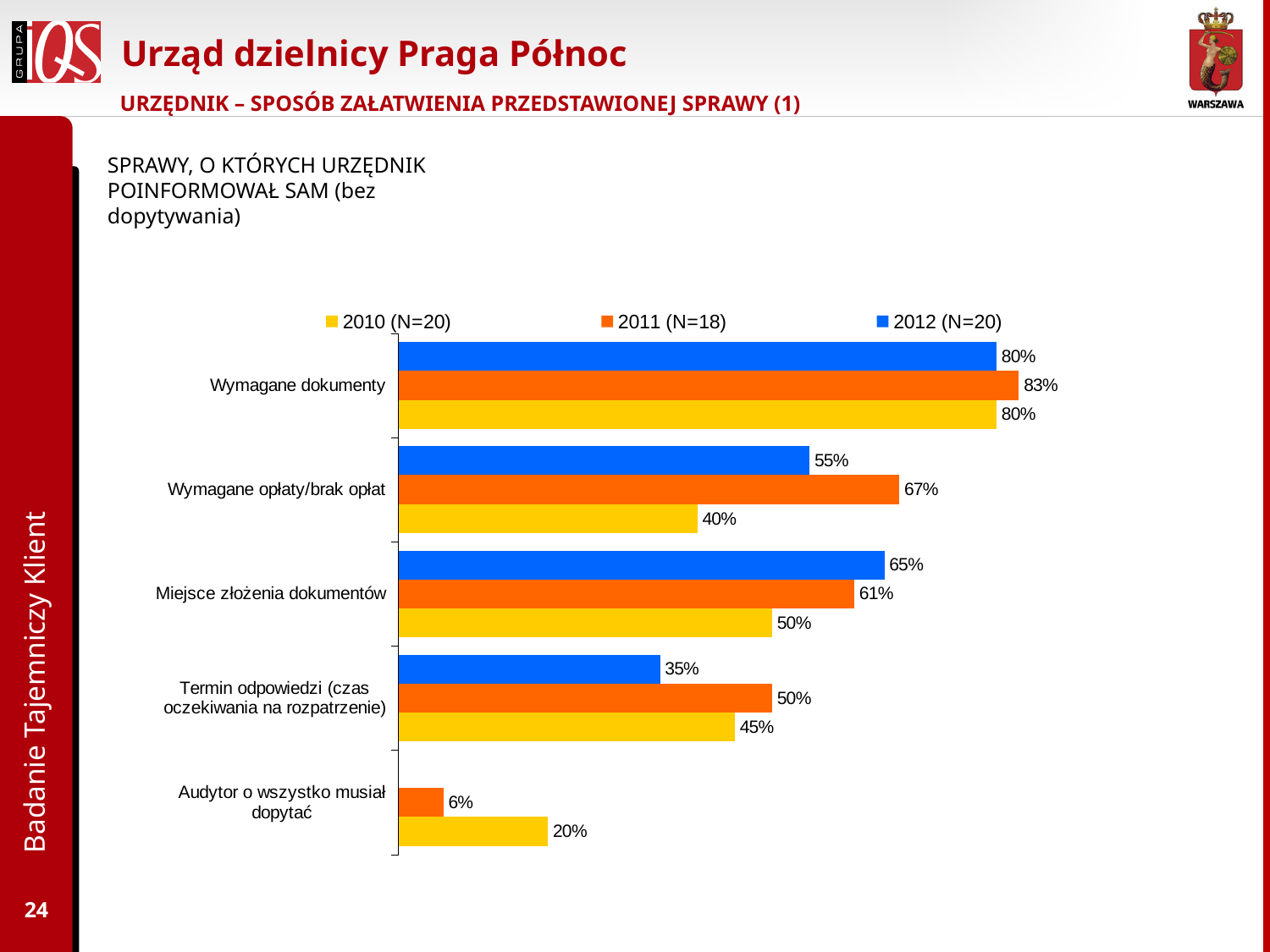
Which category has the lowest value in the 2010 (N=20) series? Audytor o wszystko musiał dopytać Which colour represents the 2012 (N=20) series in the legend? Blue How many series does the legend list? 3 For 'Miejsce złożenia dokumentów', which series has the larger value: 2012 (N=20) or 2011 (N=18)? 2012 (N=20) What kind of chart is shown on the slide? Bar chart What is the value for 'Termin odpowiedzi (czas oczekiwania na rozpatrzenie)' in the 2012 (N=20) series? 35% Which category has the highest value in the 2012 (N=20) series? Wymagane dokumenty What is the difference between the 2011 (N=18) and 2010 (N=20) values for 'Wymagane opłaty/brak opłat'? 27% What is the value for 'Wymagane dokumenty' in the 2011 (N=18) series? 83% How many categories are shown on the chart? 5 What is the value for 'Audytor o wszystko musiał dopytać' in the 2011 (N=18) series? 6% What is the value for 'Wymagane opłaty/brak opłat' in the 2010 (N=20) series? 40%